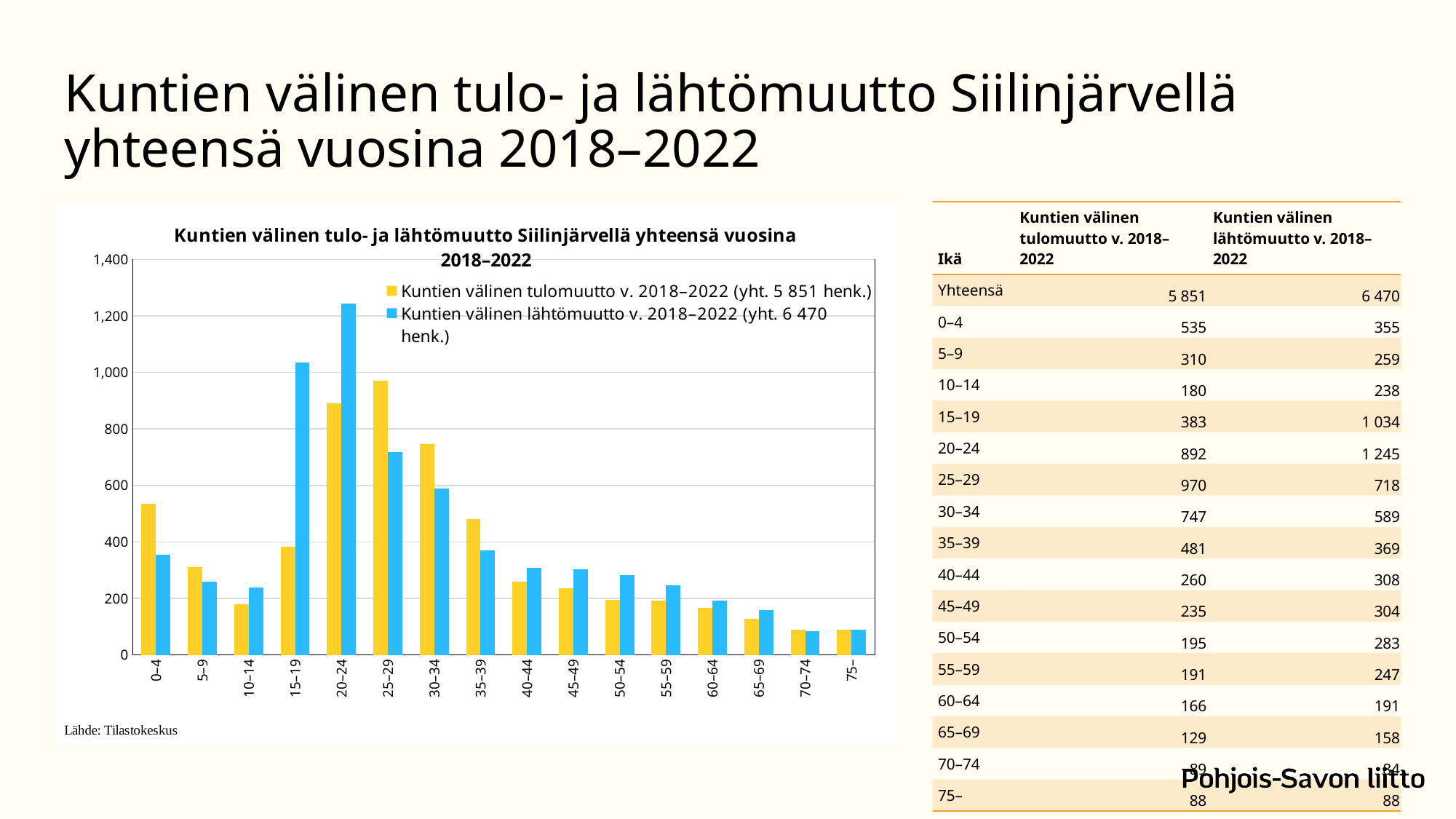
Is the value of Kuntien välinen tulomuutto for the 30–34 age group greater or less than 600? greater For the 0–4 age group, which is larger: tulomuutto or lähtömuutto? tulomuutto What kind of chart is shown on the slide? bar chart According to the legend, what is the total number of persons for Kuntien välinen lähtömuutto v. 2018–2022? 6 470 henk. Do the tulomuutto values rise or fall along the x axis from the 25–29 age group to the 75– age group? fall Which age group has the highest value for Kuntien välinen tulomuutto v. 2018–2022? 25–29 How many series does the chart legend list? 2 What is the difference between lähtömuutto and tulomuutto for the 20–24 age group? 353 How many age groups are shown on the x axis of the chart? 16 What is the value of Kuntien välinen tulomuutto v. 2018–2022 for the 25–29 age group? 970 Which age group has the highest value for Kuntien välinen lähtömuutto v. 2018–2022? 20–24 What is the value of Kuntien välinen lähtömuutto v. 2018–2022 for the 15–19 age group? 1 034